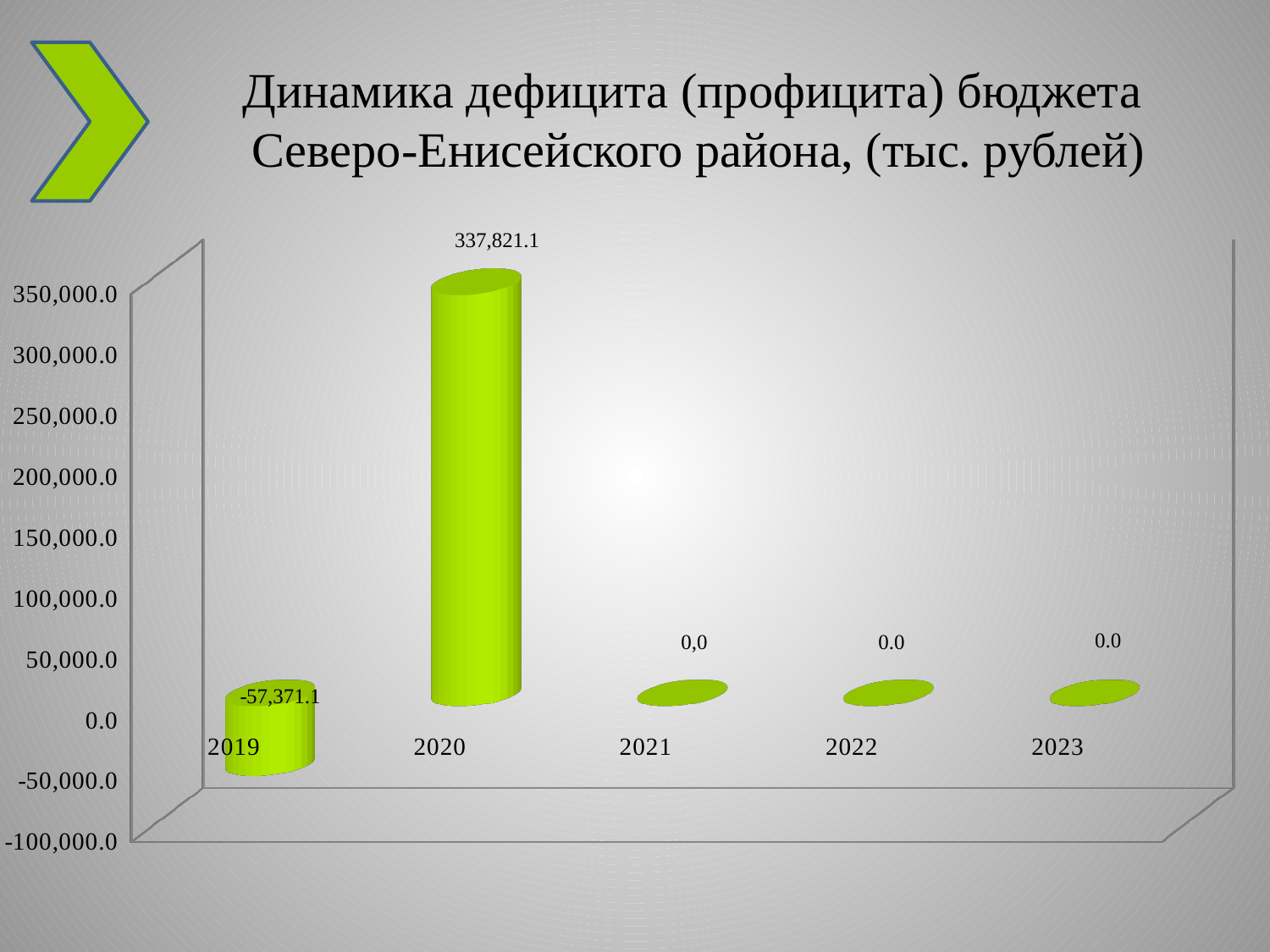
What unit is given in the chart title? тыс. рублей What is the value for 2020? 337,821.1 What is the difference between the values for 2020 and 2019? 395,192.2 Which year has the lowest value? 2019 Which year has the highest value? 2020 What is the value for 2019? -57,371.1 How many years are shown on the x axis? 5 Is the value for 2020 greater or less than 300,000.0? greater Which is larger, the value for 2019 or the value for 2021? 2021 What is the value for 2022? 0.0 Does the value rise or fall from 2019 to 2020? rise What kind of chart is shown on the slide? bar chart